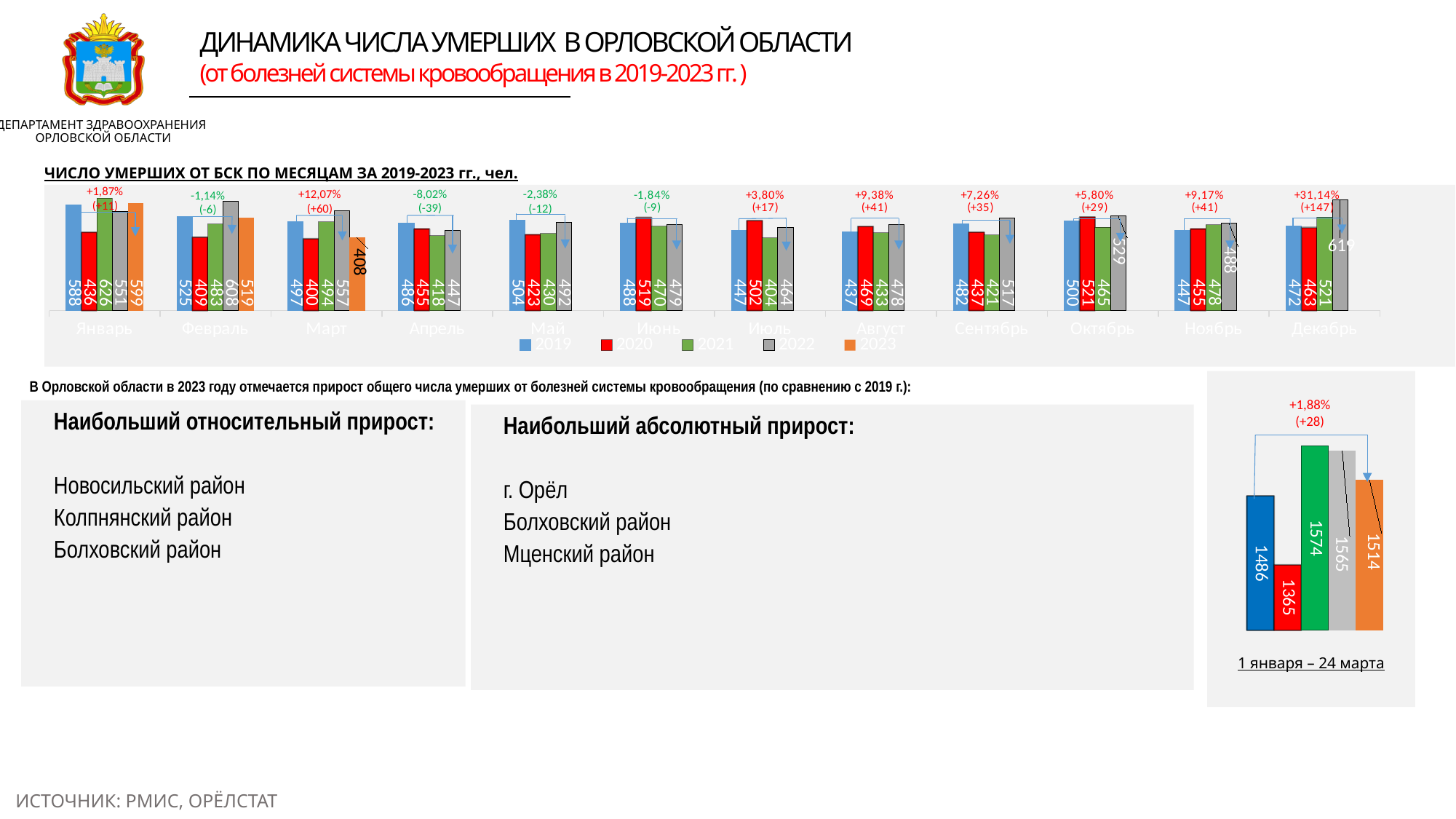
In the chart 'ЧИСЛО УМЕРШИХ ОТ БСК ПО МЕСЯЦАМ ЗА 2019-2023 гг., чел.', what is the value for 2022 in Февраль? 608 In the chart 'ЧИСЛО УМЕРШИХ ОТ БСК ПО МЕСЯЦАМ ЗА 2019-2023 гг., чел.', what is the difference between the 2023 and 2019 values in Январь? 11 In the chart 'ЧИСЛО УМЕРШИХ ОТ БСК ПО МЕСЯЦАМ ЗА 2019-2023 гг., чел.', what is the value for 2019 in Январь? 588 In the chart 'ЧИСЛО УМЕРШИХ ОТ БСК ПО МЕСЯЦАМ ЗА 2019-2023 гг., чел.', which year has the lowest value in Март? 2020 How many series does the legend of the chart 'ЧИСЛО УМЕРШИХ ОТ БСК ПО МЕСЯЦАМ ЗА 2019-2023 гг., чел.' list? 5 In the chart 'ЧИСЛО УМЕРШИХ ОТ БСК ПО МЕСЯЦАМ ЗА 2019-2023 гг., чел.', which year has the highest value in Январь? 2021 In the chart 'ЧИСЛО УМЕРШИХ ОТ БСК ПО МЕСЯЦАМ ЗА 2019-2023 гг., чел.', what is the value for 2023 in Март? 408 In the small chart on the right labelled '1 января – 24 марта', what is the value of the green bar? 1574 In the small chart on the right labelled '1 января – 24 марта', what is the lowest value shown? 1365 In the chart 'ЧИСЛО УМЕРШИХ ОТ БСК ПО МЕСЯЦАМ ЗА 2019-2023 гг., чел.', which is larger in Июнь: the 2019 value or the 2020 value? 2020 What kind of chart is 'ЧИСЛО УМЕРШИХ ОТ БСК ПО МЕСЯЦАМ ЗА 2019-2023 гг., чел.'? bar chart How many months are shown on the x axis of the chart 'ЧИСЛО УМЕРШИХ ОТ БСК ПО МЕСЯЦАМ ЗА 2019-2023 гг., чел.'? 12